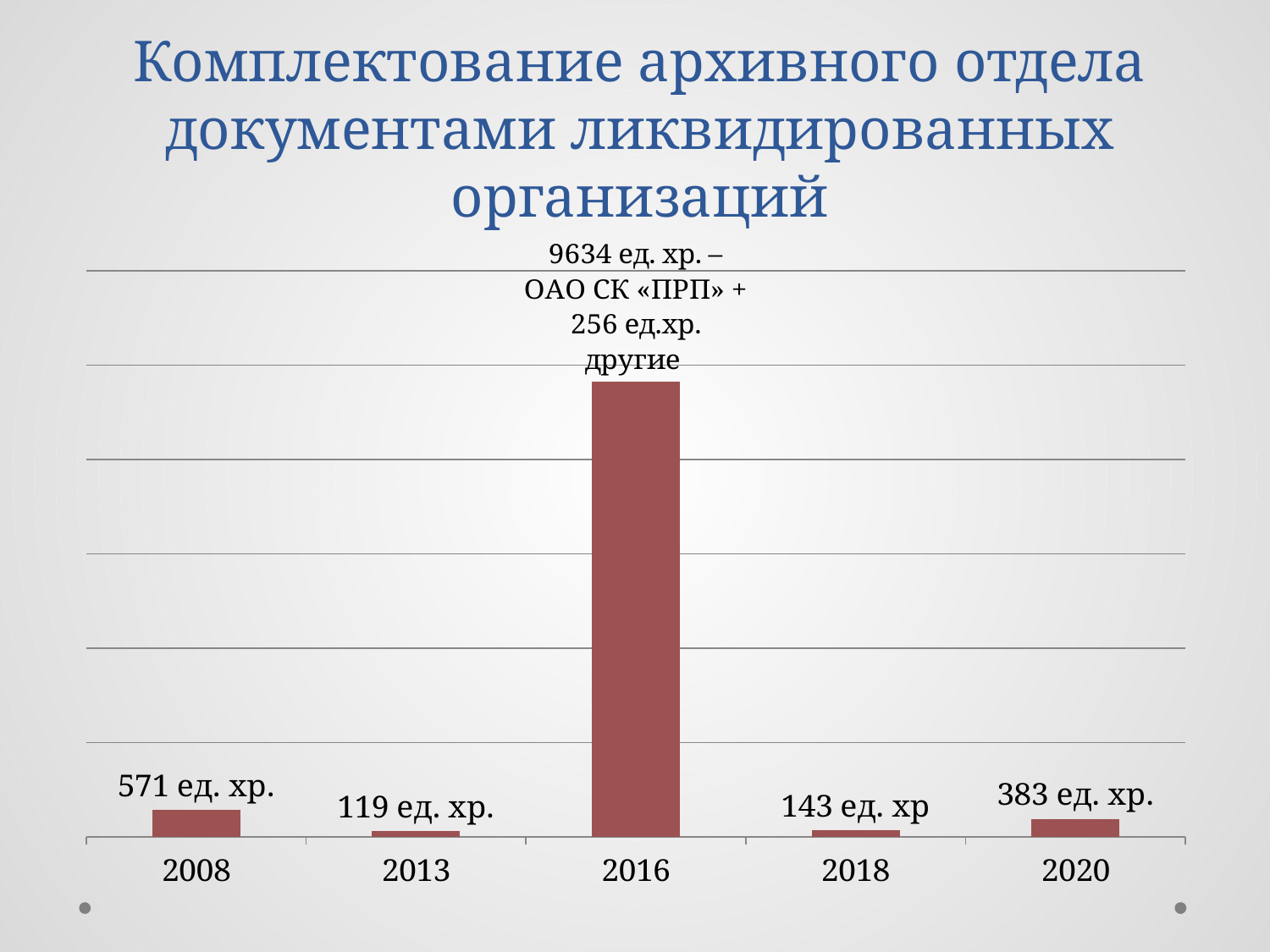
What is the value shown for 2020? 383 ед. хр. According to the data label, how many ед. хр. in 2016 came from ОАО СК «ПРП»? 9634 ед. хр. What is the difference between the values for 2008 and 2013? 452 ед. хр. What is the value shown for 2018? 143 ед. хр What is the value shown for 2008? 571 ед. хр. What is the difference between the values for 2020 and 2018? 240 ед. хр. Which year has the lowest value in the chart? 2013 What type of chart is shown on the slide? bar chart What is the value shown for 2013? 119 ед. хр. Which is larger, the value for 2008 or the value for 2020? 2008 Which year has the highest bar in the chart? 2016 How many years (categories) are shown on the x axis of the chart? 5